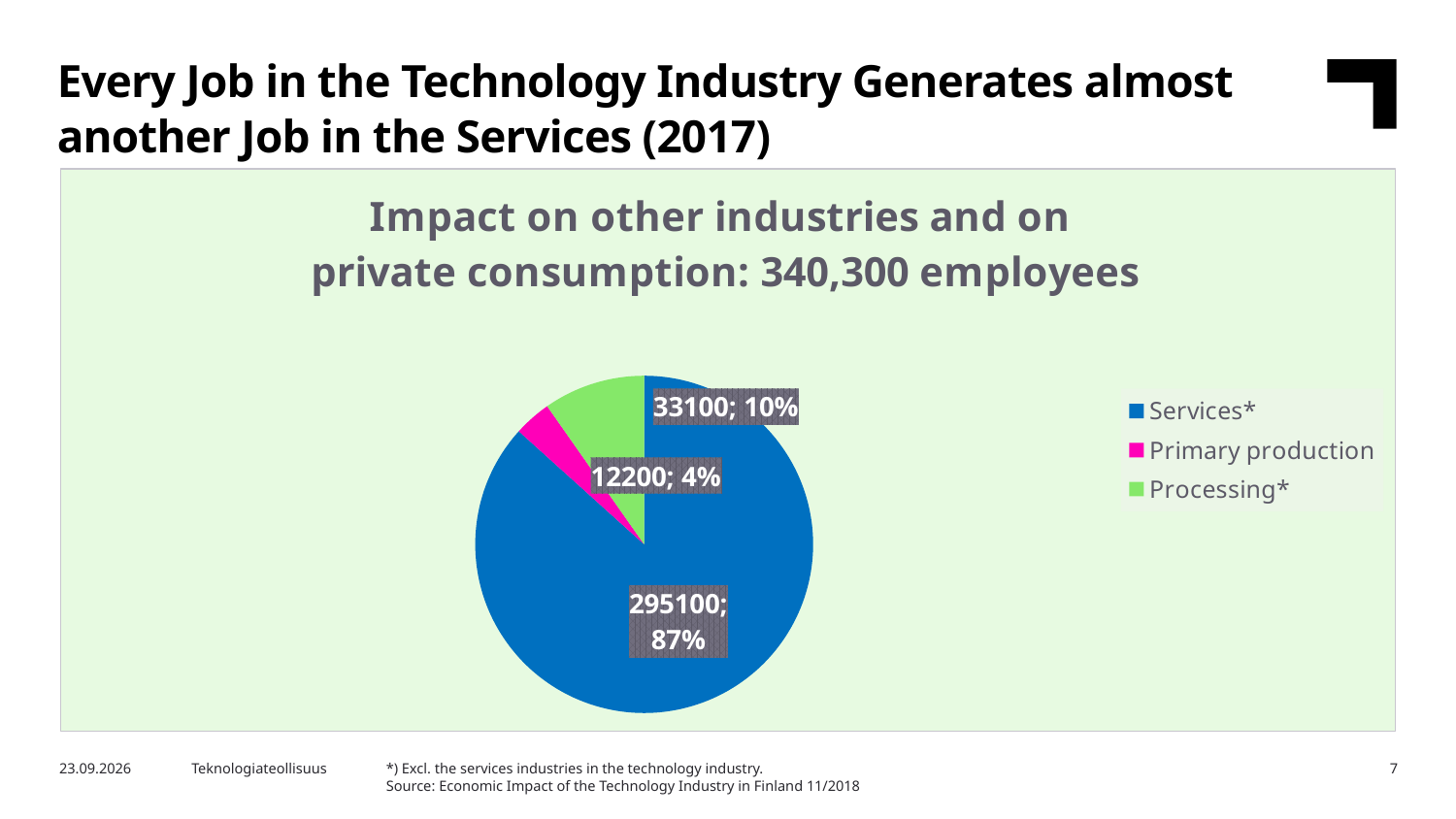
How many employees does the Primary production slice represent? 12200 What is the title shown above the pie chart? Impact on other industries and on private consumption: 340,300 employees Which category has the largest slice of the pie? Services* Which is larger, the Processing* slice or the Primary production slice? Processing* What is the difference in employees between Processing* and Primary production? 20900 What kind of chart is shown on the slide? pie chart What percentage share does the Services* slice have? 87% What percentage share does the Processing* slice have? 10% How many employees does the Services* slice represent? 295100 What colour is the Primary production slice? pink How many categories does the legend list? 3 Which category has the smallest slice of the pie? Primary production